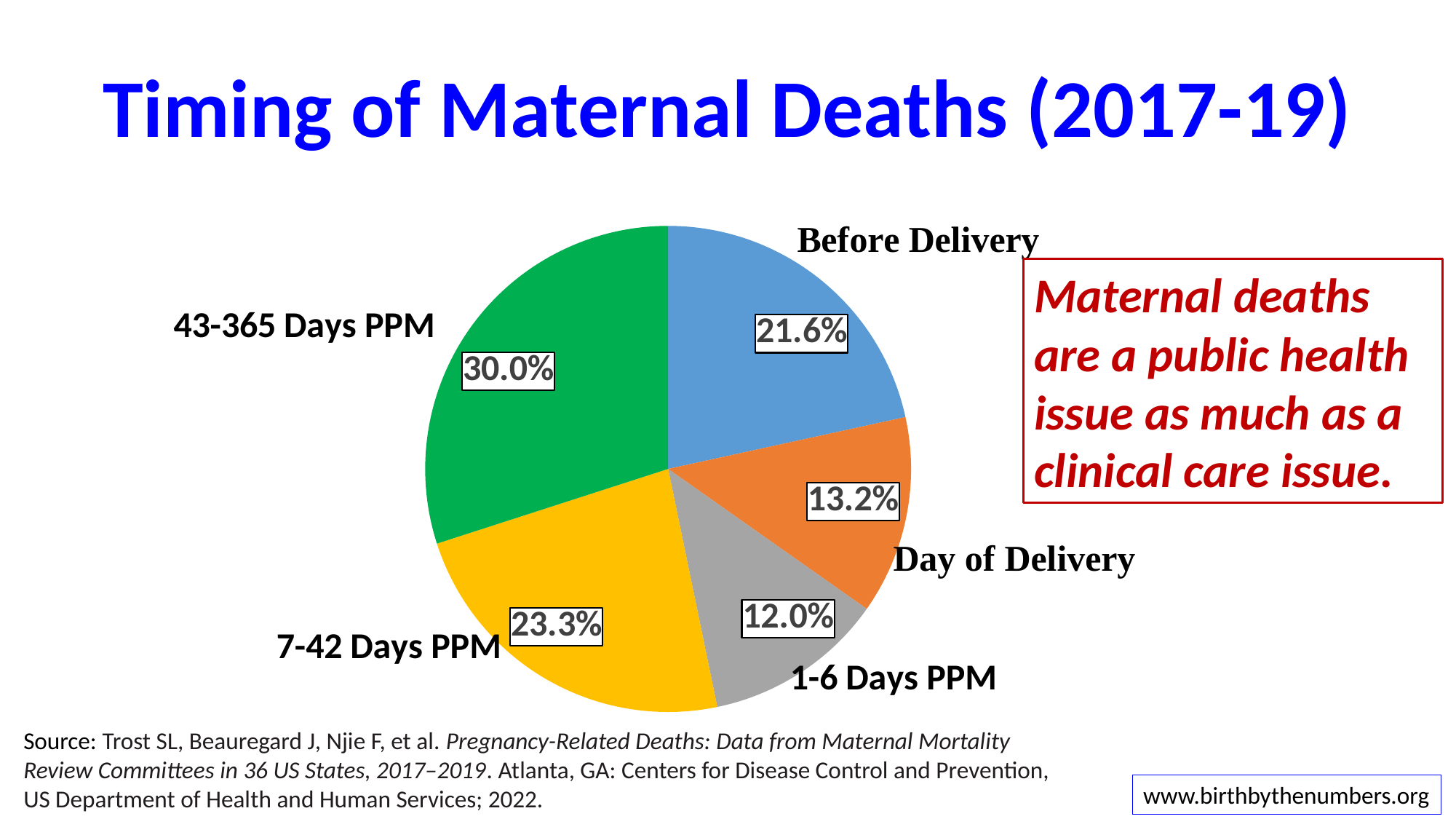
What share of maternal deaths occurred 1-6 days postpartum? 12.0% What is the difference in percentage points between the Day of Delivery and 1-6 Days PPM shares? 1.2 What percentage of maternal deaths occurred on the day of delivery? 13.2% What colour is the slice representing 7-42 Days PPM? Yellow Which timing category accounts for the largest share of maternal deaths? 43-365 Days PPM Which is larger: the share for 7-42 Days PPM or the share for Before Delivery? 7-42 Days PPM How many percentage points larger is the 43-365 Days PPM share than the Before Delivery share? 8.4 What percentage of maternal deaths occurred 7-42 days postpartum? 23.3% What type of chart is used on this slide? Pie chart Which timing category accounts for the smallest share of maternal deaths? 1-6 Days PPM How many timing categories are shown in the pie chart? 5 What share of maternal deaths occurred before delivery? 21.6%